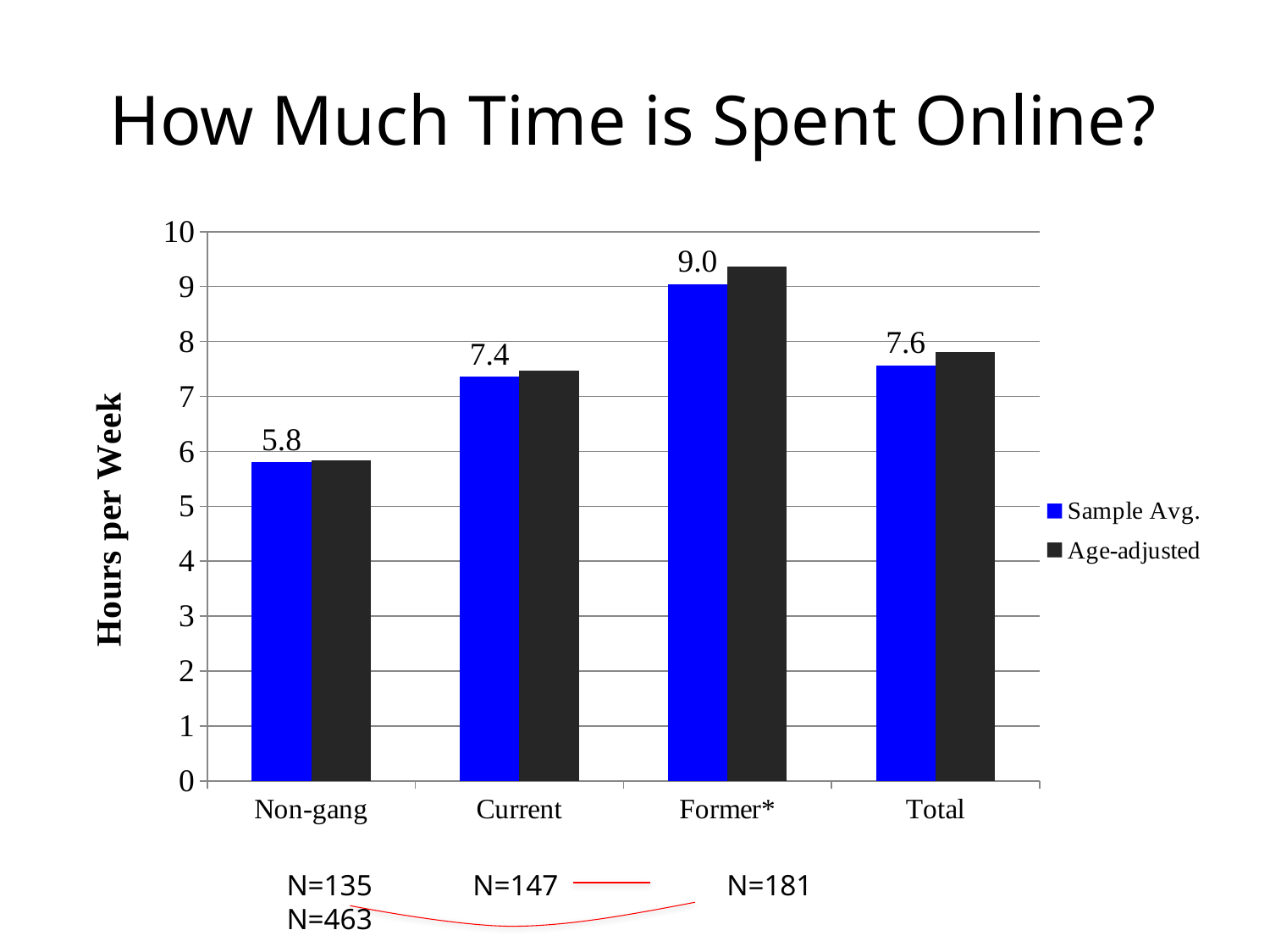
What is the Sample Avg. value for Non-gang? 5.8 Which has the larger Sample Avg. value, Current or Total? Total Which category has the highest Sample Avg. hours per week? Former* What is the difference between the Sample Avg. values for Former* and Non-gang? 3.2 What is the Sample Avg. value for Current? 7.4 What is the Sample Avg. value for Total? 7.6 Is the Age-adjusted value for Former* greater or less than 9? greater Which category has the lowest Sample Avg. hours per week? Non-gang How many categories are shown on the x axis? 4 What is the Sample Avg. value for Former*? 9.0 How many series does the legend list? 2 What kind of chart is shown on the slide? bar chart